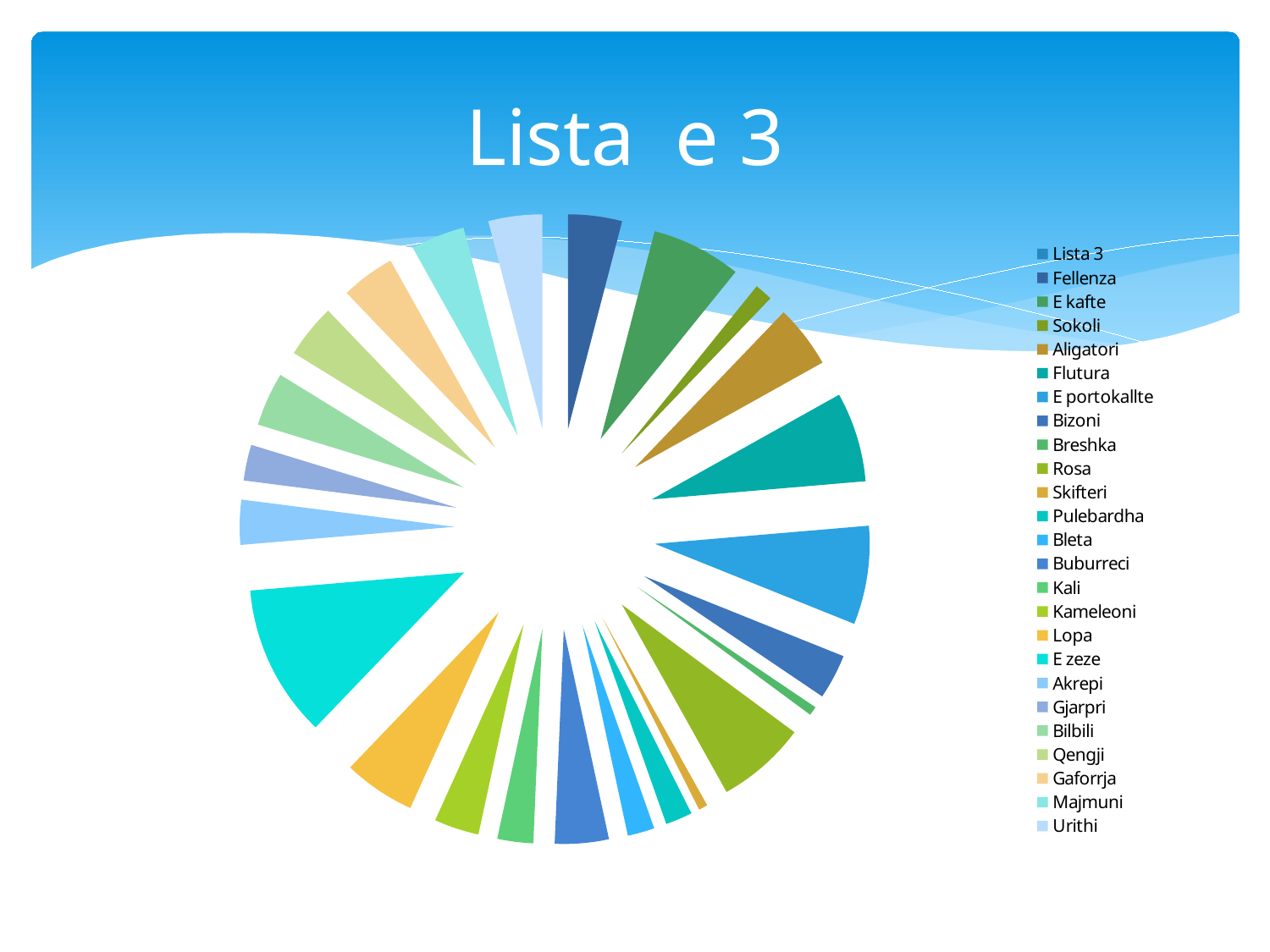
Which slice is larger, E portokallte or Skifteri? E portokallte Which slice is larger, E zeze or Sokoli? E zeze Which slice is larger, Lopa or Gjarpri? Lopa How many entries does the chart's legend list? 25 What kind of chart is shown on the slide? pie chart What is the title of the slide containing the chart? Lista e 3 Which entry appears first in the chart's legend? Lista 3